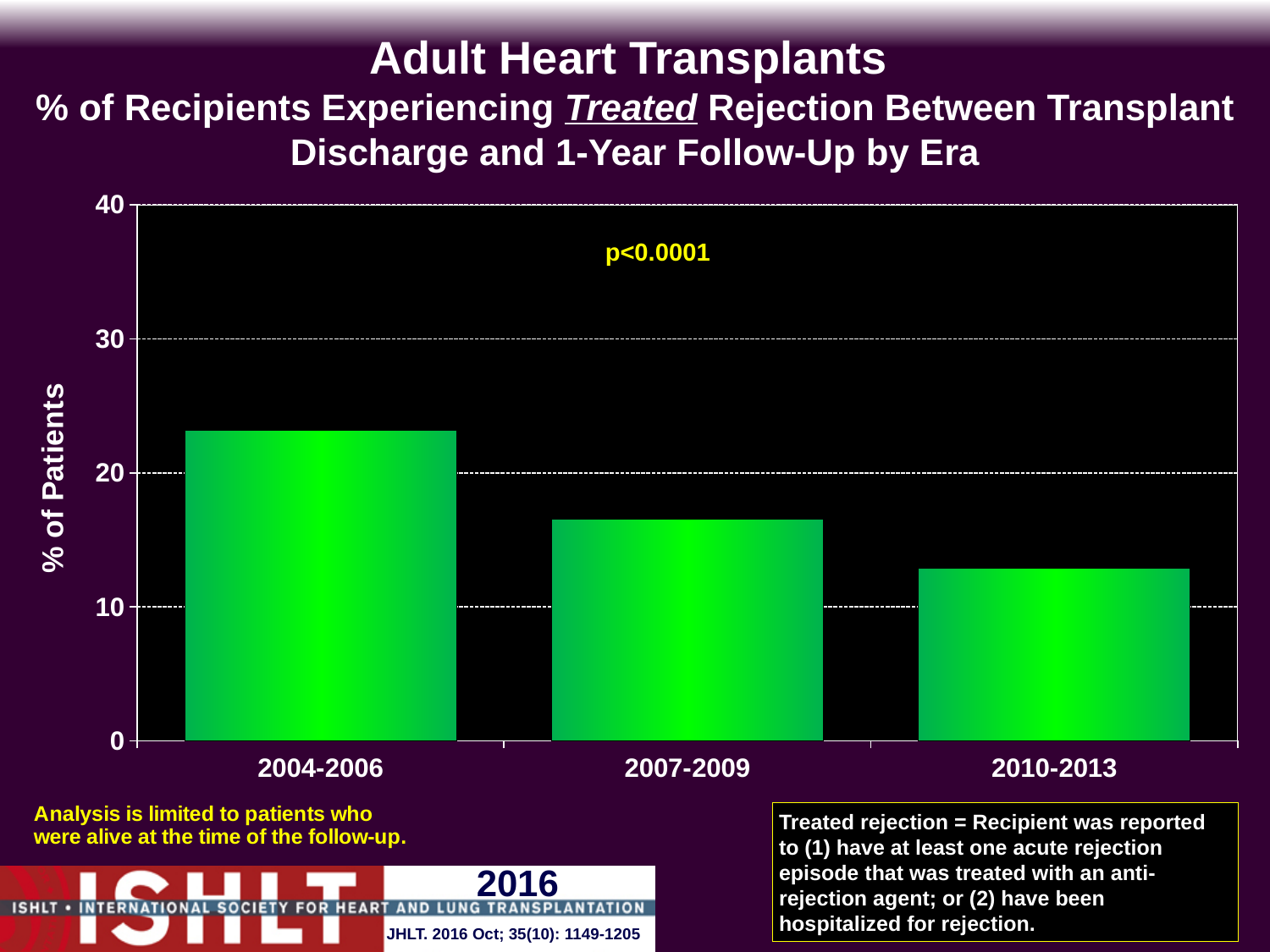
What is the label of the y axis? % of Patients Which is larger, the value for 2007-2009 or the value for 2010-2013? 2007-2009 What p-value is printed on the chart? p<0.0001 Which era has the highest percentage of patients experiencing treated rejection? 2004-2006 Is the value for 2004-2006 greater or less than 20? greater Is the value for 2010-2013 greater or less than 10? greater Is the value for 2007-2009 greater or less than 20? less Which era has the lowest percentage of patients experiencing treated rejection? 2010-2013 How many era categories are shown on the x axis? 3 What kind of chart is shown on the slide? bar chart Do the values rise or fall across the eras from 2004-2006 to 2010-2013? fall